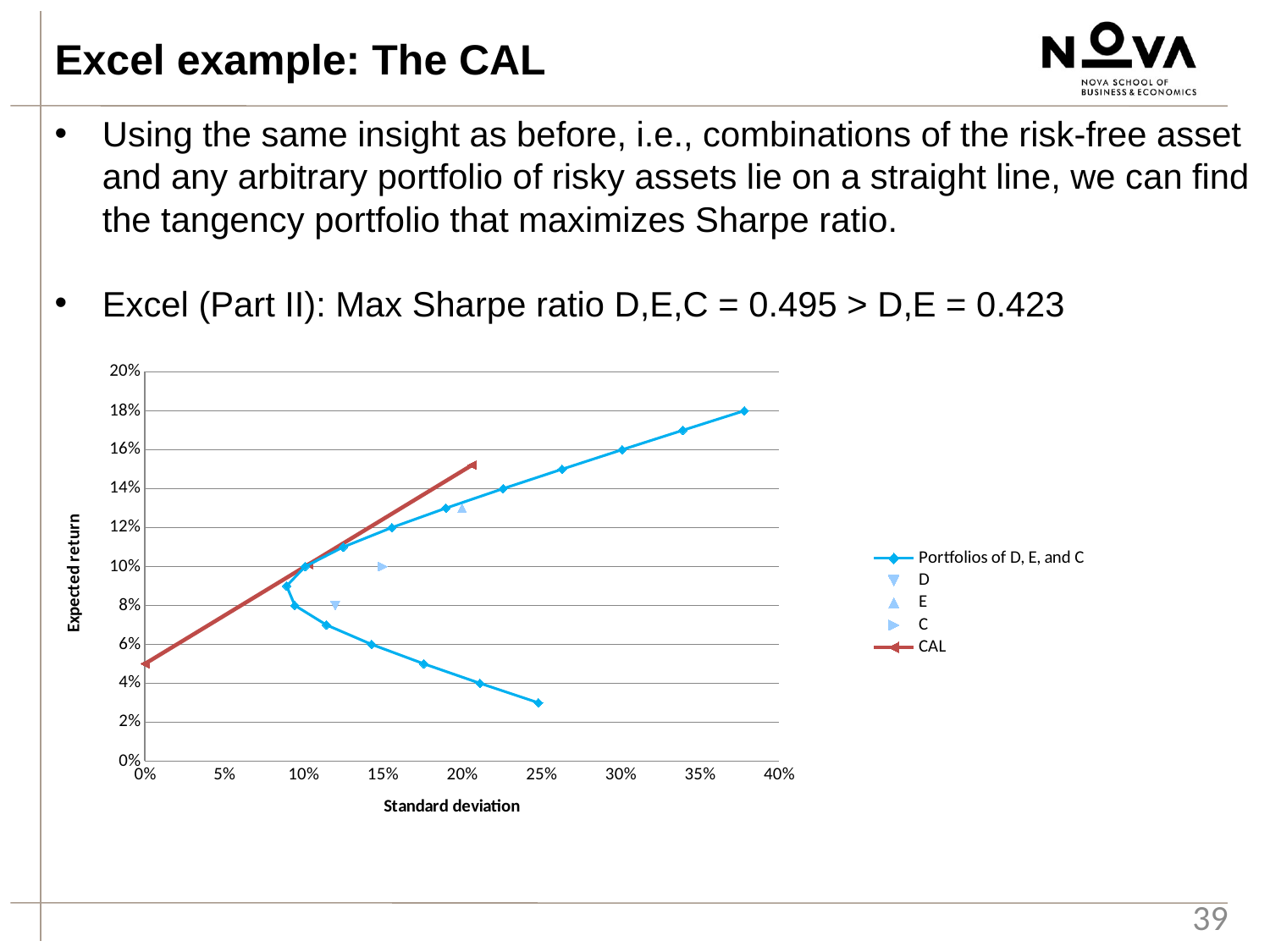
What is the title of the chart's vertical axis? Expected return Is the standard deviation of asset C greater or less than 20%? less Which asset has the higher expected return, D or E? E Is the expected return of asset E greater or less than 12%? greater What is the title of the chart's horizontal axis? Standard deviation What is the highest expected return reached by the 'Portfolios of D, E, and C' curve? 18% Is the standard deviation of asset D greater or less than 10%? greater Which asset has the higher standard deviation, C or E? E How many series does the chart's legend list? 5 Along the CAL line, does expected return rise or fall as standard deviation increases? rises What kind of chart is shown on the slide? scatter (XY) chart with lines and markers